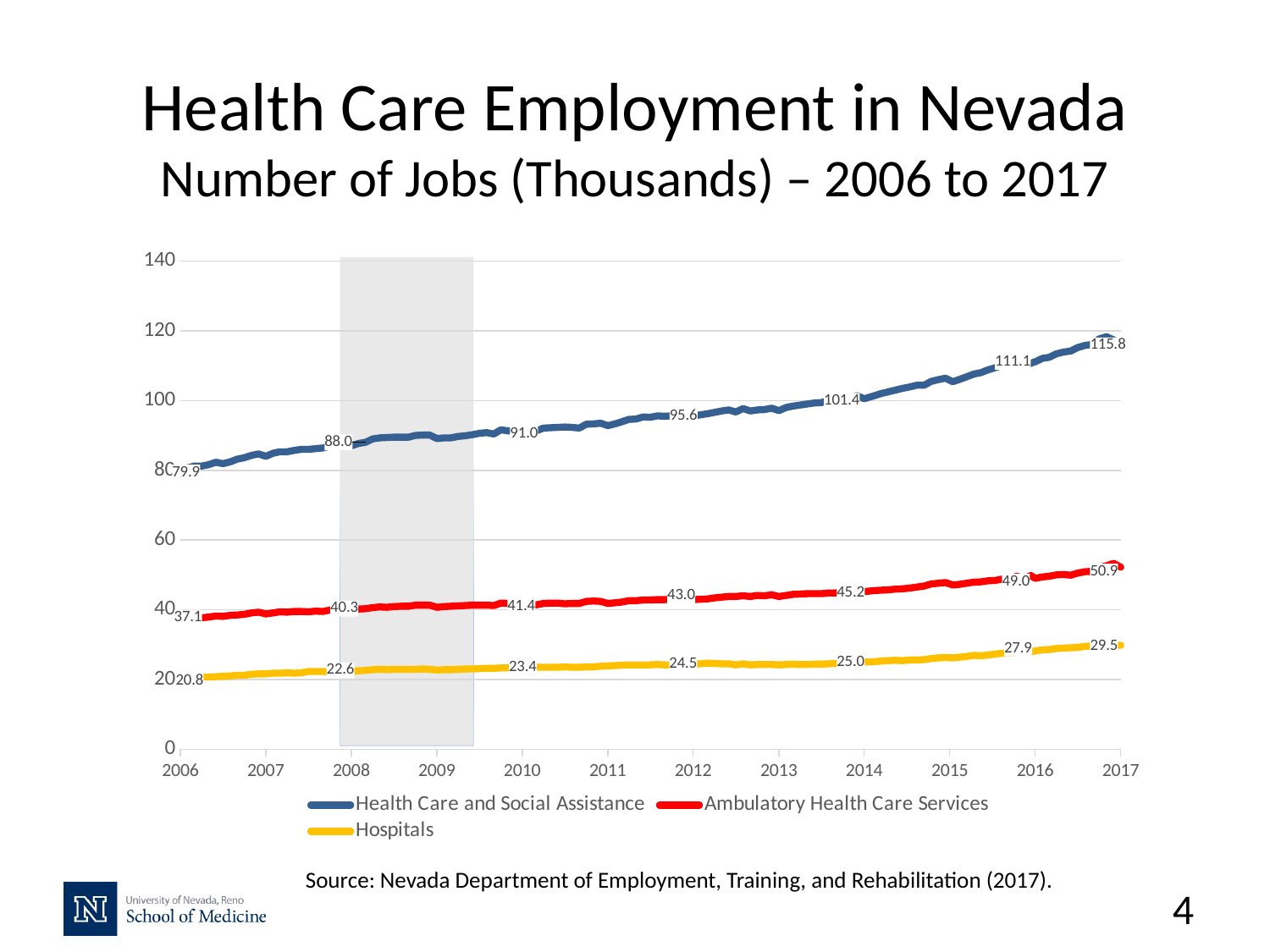
Which series has the lowest values throughout the chart? Hospitals What is the labelled value for Health Care and Social Assistance at the end of the series in 2017? 115.8 Which series has the highest values throughout the chart? Health Care and Social Assistance What is the difference between the 2017 and 2006 labelled values for Hospitals (29.5 and 20.8)? 8.7 Does the Health Care and Social Assistance series rise or fall from 2006 to 2017? rise How many series does the legend list? 3 What is the labelled value for Ambulatory Health Care Services at the start of the series in 2006? 37.1 Is the value for Ambulatory Health Care Services in 2017 greater or less than 60? less What type of chart is shown on the slide? line chart Which is larger: the 2016 value for Ambulatory Health Care Services (49.0) or the 2016 value for Hospitals (27.9)? Ambulatory Health Care Services What is the labelled value for Hospitals in 2014? 25.0 What is the labelled value for Health Care and Social Assistance in 2012? 95.6